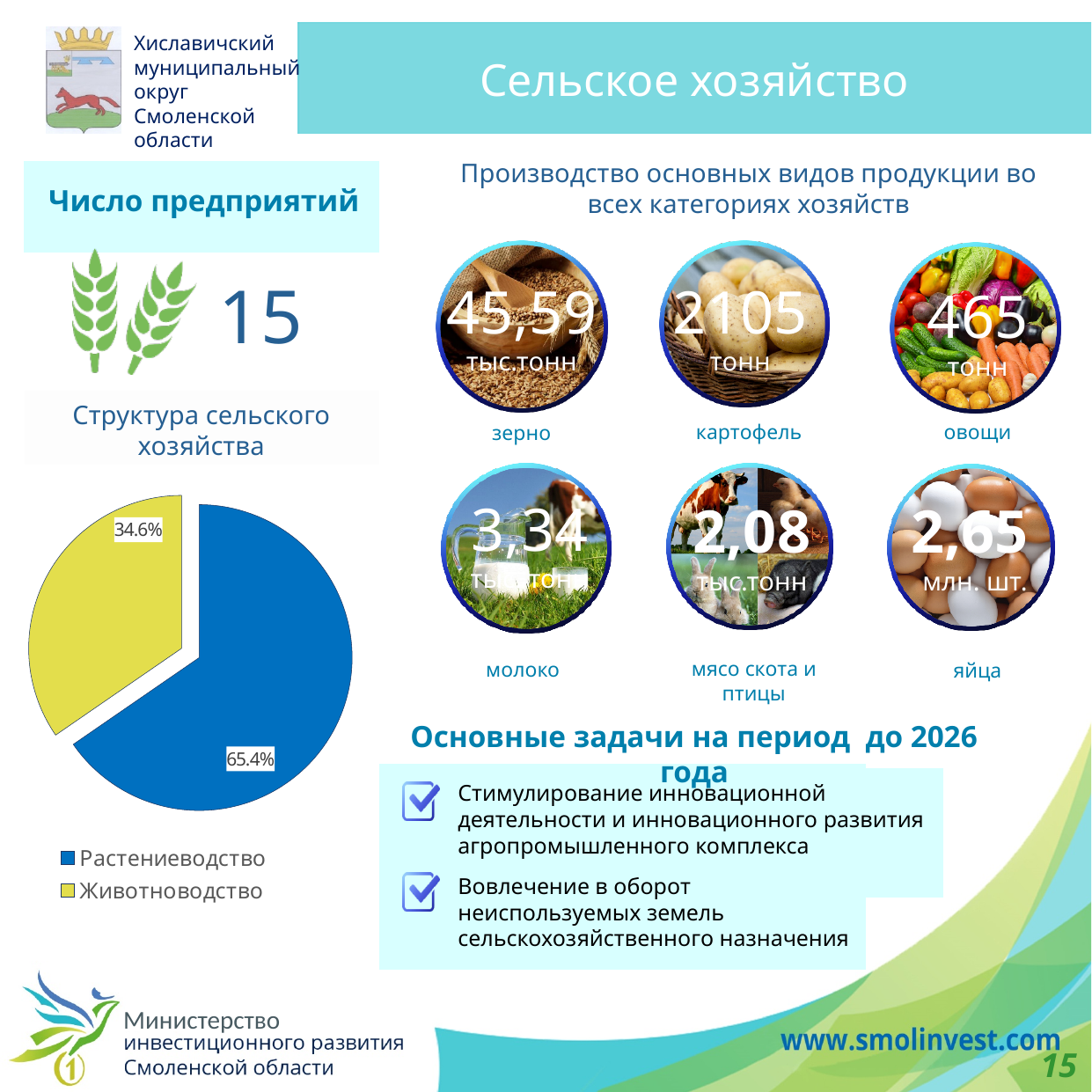
In the pie chart "Структура сельского хозяйства", what is the difference in percentage points between Растениеводство and Животноводство? 30.8 In the pie chart "Структура сельского хозяйства", which slice is the smallest? Животноводство In the pie chart "Структура сельского хозяйства", which slice is the largest? Растениеводство How many slices does the pie chart "Структура сельского хозяйства" have? 2 In the pie chart "Структура сельского хозяйства", what colour is the Животноводство slice? yellow In the pie chart "Структура сельского хозяйства", what share is labelled for Животноводство? 34.6% How many entries does the legend of the pie chart "Структура сельского хозяйства" list? 2 In the pie chart "Структура сельского хозяйства", what colour is the Растениеводство slice? blue In the pie chart "Структура сельского хозяйства", what share is labelled for Растениеводство? 65.4% In the pie chart "Структура сельского хозяйства", which is larger: Растениеводство or Животноводство? Растениеводство What kind of chart is shown under the heading "Структура сельского хозяйства"? pie chart